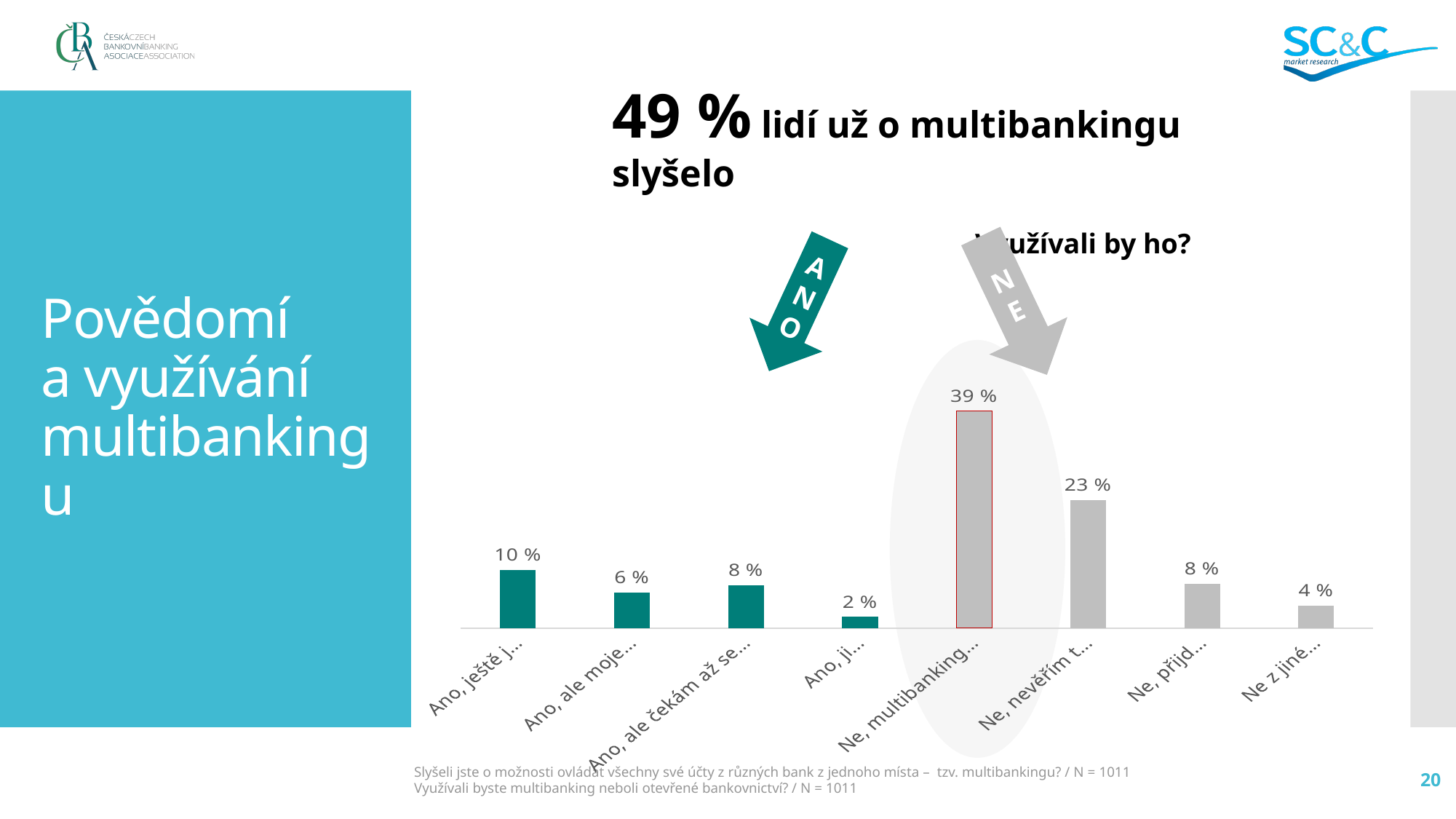
What colour are the four "Ano" bars on the left of the chart? teal (dark green) What is the value of the bar labelled "Ano, ji..."? 2 % What is the value of the first bar, labelled "Ano, ještě j..."? 10 % What is the value of the highlighted bar labelled "Ne, multibanking..."? 39 % Which is larger, the "Ano, ještě j..." bar or the "Ano, ale moje..." bar? Ano, ještě j... How many bars does the chart contain? 8 Which bar has the lowest value? Ano, ji... What is the value of the last bar, labelled "Ne z jiné..."? 4 % What is the difference between the "Ne, multibanking..." bar and the "Ne, nevěřím t..." bar? 16 % Which bar has the highest value? Ne, multibanking... What is the value of the bar labelled "Ne, nevěřím t..."? 23 % What kind of chart is shown on the slide? bar chart